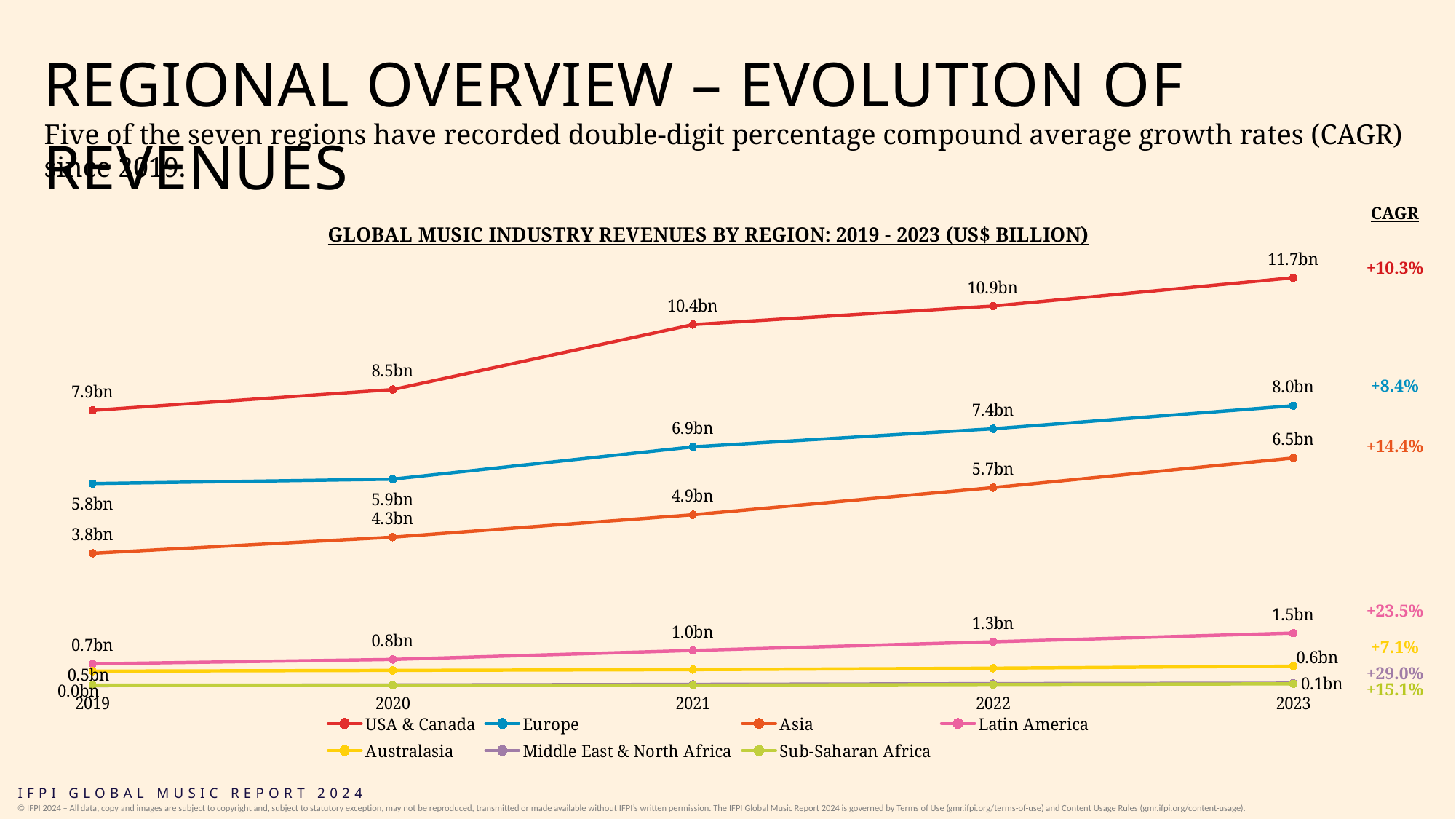
What was the revenue for Latin America in 2022? 1.3bn What is the title of the chart? GLOBAL MUSIC INDUSTRY REVENUES BY REGION: 2019 - 2023 (US$ BILLION) What was the revenue for Europe in 2021? 6.9bn How many years are shown on the x axis? 5 Which region had the highest revenue in 2023? USA & Canada What type of chart is shown on the slide? Line chart What was the revenue for Asia in 2019? 3.8bn What was the revenue for USA & Canada in 2023? 11.7bn How many series does the legend list? 7 By how much did USA & Canada revenue grow from 2019 to 2023? 3.8bn Which was larger in 2022, Europe or Asia revenue? Europe Does Asia's revenue rise or fall from 2019 to 2023? Rise